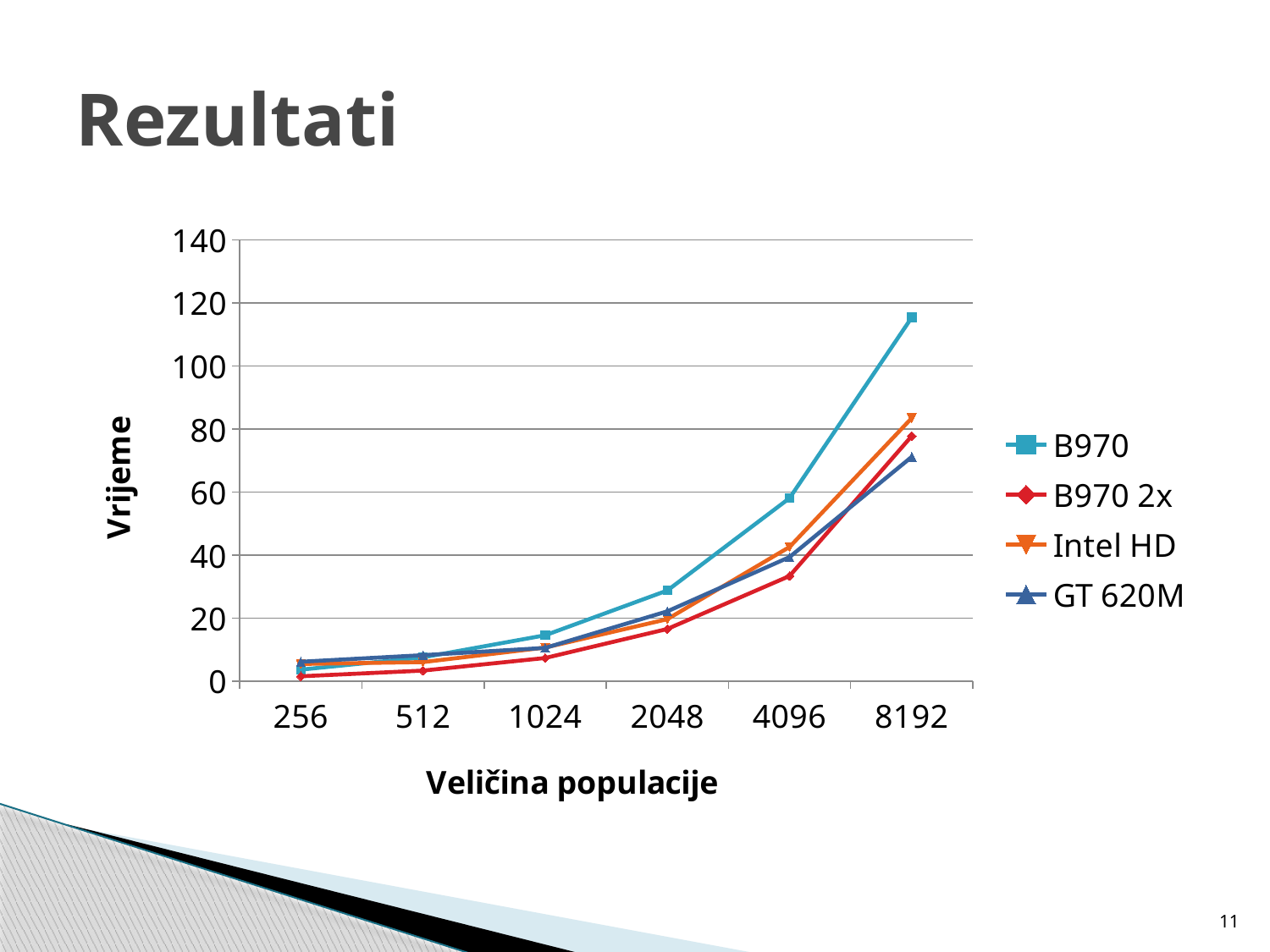
Which series has the highest value at population size 8192? B970 How many population sizes are shown on the x axis? 6 Is the value for B970 at population size 8192 greater or less than 100? greater Is the value for Intel HD at population size 8192 greater or less than 100? less Is the value for B970 at population size 4096 greater or less than 40? greater At population size 4096, which is larger: B970 or B970 2x? B970 What kind of chart is shown on the slide? line chart Do the values for B970 rise or fall as the population size increases? rise What is the title of the x axis? Veličina populacije Which series has the lowest value at population size 8192? GT 620M How many series does the legend list? 4